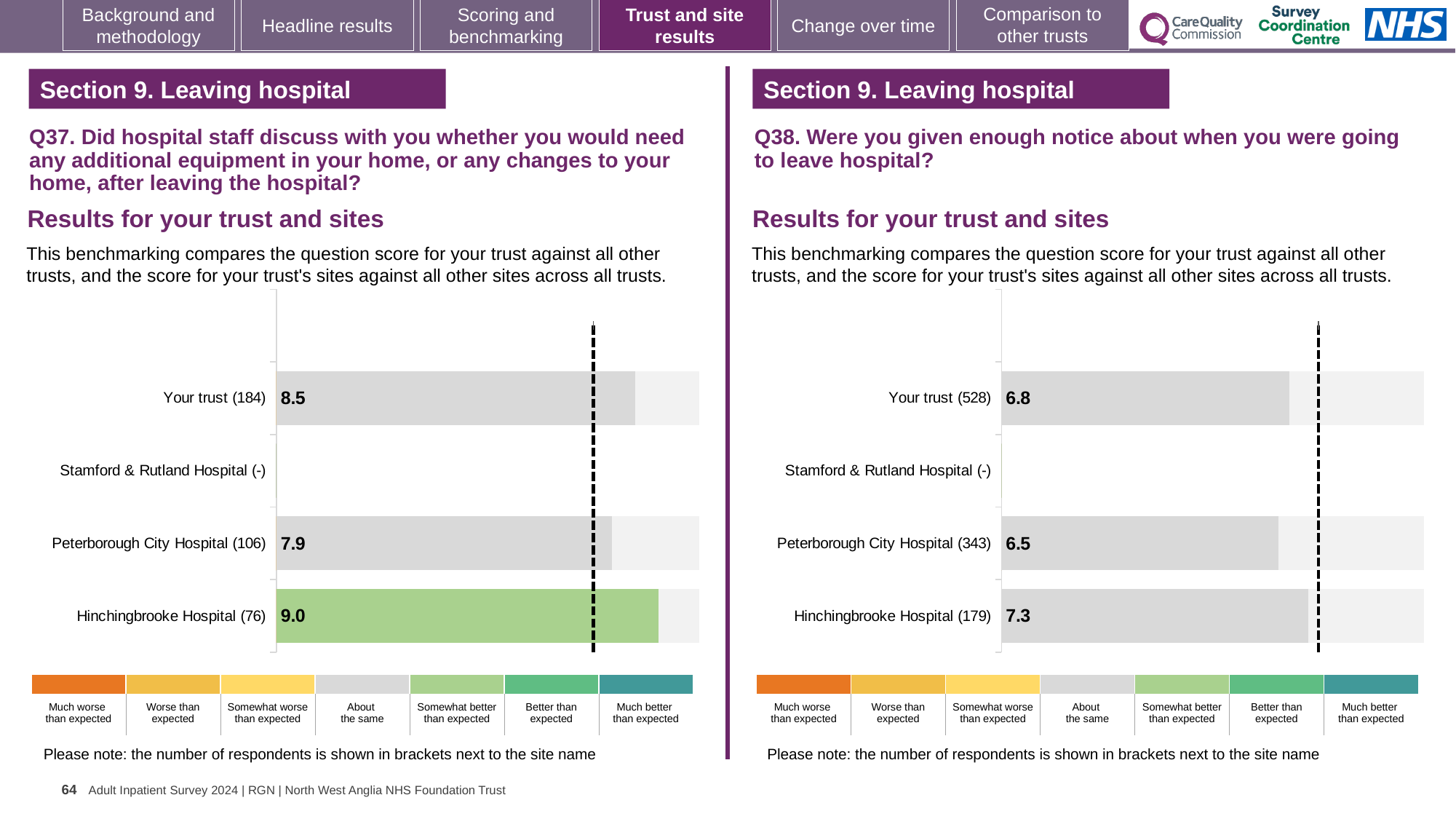
In the Q37 chart on the left, what is the score for Hinchingbrooke Hospital? 9.0 In the Q37 chart on the left, which site's bar is coloured green, indicating 'Somewhat better than expected'? Hinchingbrooke Hospital What kind of chart is used in the Q37 chart on the left? bar chart In the Q37 chart on the left, what is the score for Your trust? 8.5 In the Q38 chart on the right, what is the difference between the scores for Hinchingbrooke Hospital and Your trust? 0.5 In the Q37 chart on the left, how many respondents are shown in brackets for Peterborough City Hospital? 106 In the Q37 chart on the left, what is the difference between the scores for Hinchingbrooke Hospital and Peterborough City Hospital? 1.1 In the Q38 chart on the right, is the score for Hinchingbrooke Hospital larger or smaller than the score for Your trust? larger In the Q38 chart on the right, what is the score for Your trust? 6.8 In the Q38 chart on the right, what is the score for Peterborough City Hospital? 6.5 In the Q37 chart on the left, which site has the highest score? Hinchingbrooke Hospital In the Q38 chart on the right, which site has the lowest score among those with a value shown? Peterborough City Hospital